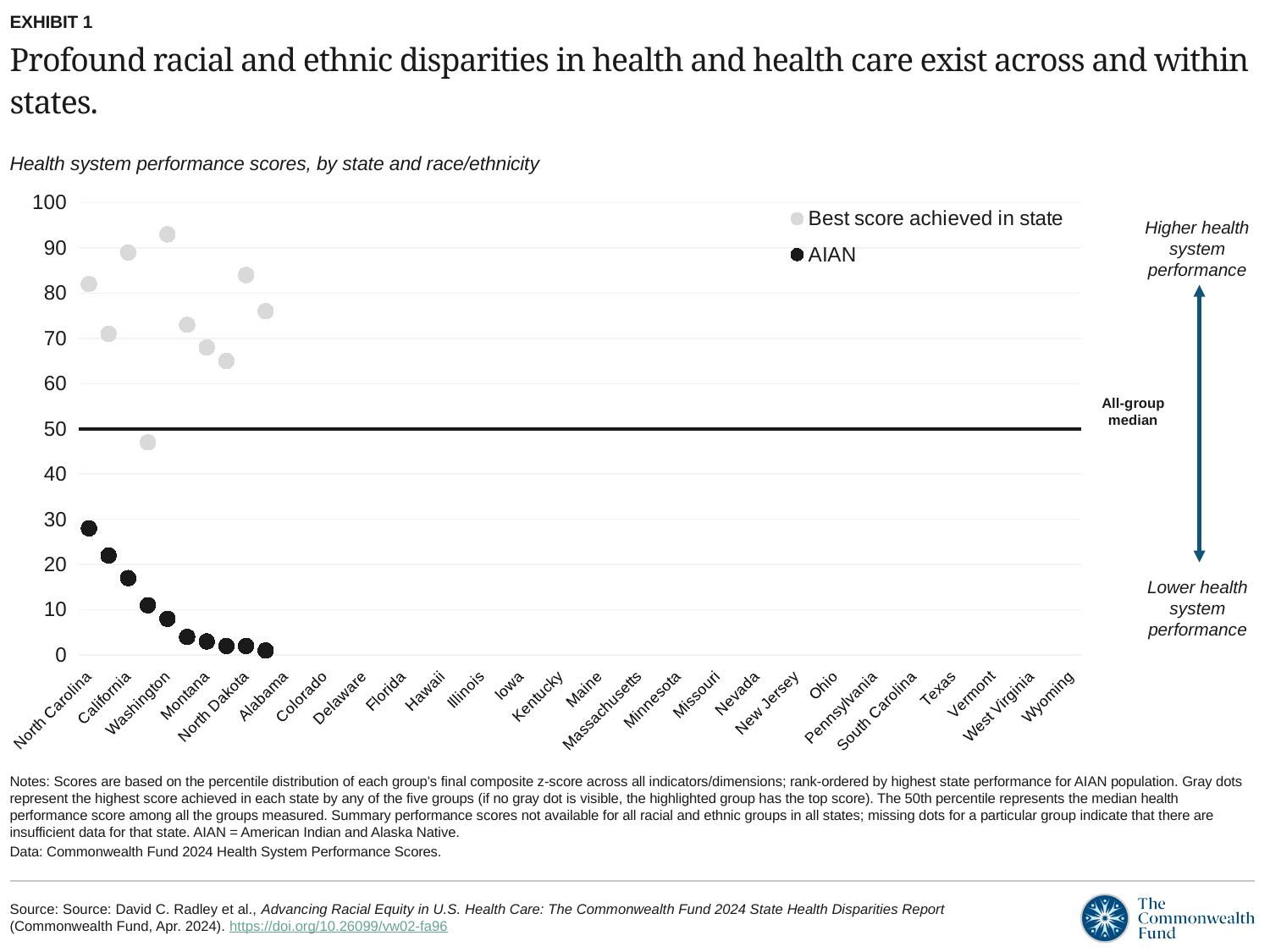
Is the highest AIAN score greater or less than the all-group median of 50? less What are the two series named in the legend? Best score achieved in state; AIAN Do the AIAN scores rise or fall moving left to right along the x axis? fall How many black AIAN dots are plotted on the chart? 10 Is the AIAN score for North Carolina greater or less than 20? greater Which state has the highest AIAN score? North Carolina Is the AIAN score for North Carolina greater or less than 40? less At what score is the horizontal 'All-group median' line drawn? 50 How many series does the legend list? 2 What kind of chart is shown on the slide? Scatter (dot) chart How many state labels are shown on the x axis? 26